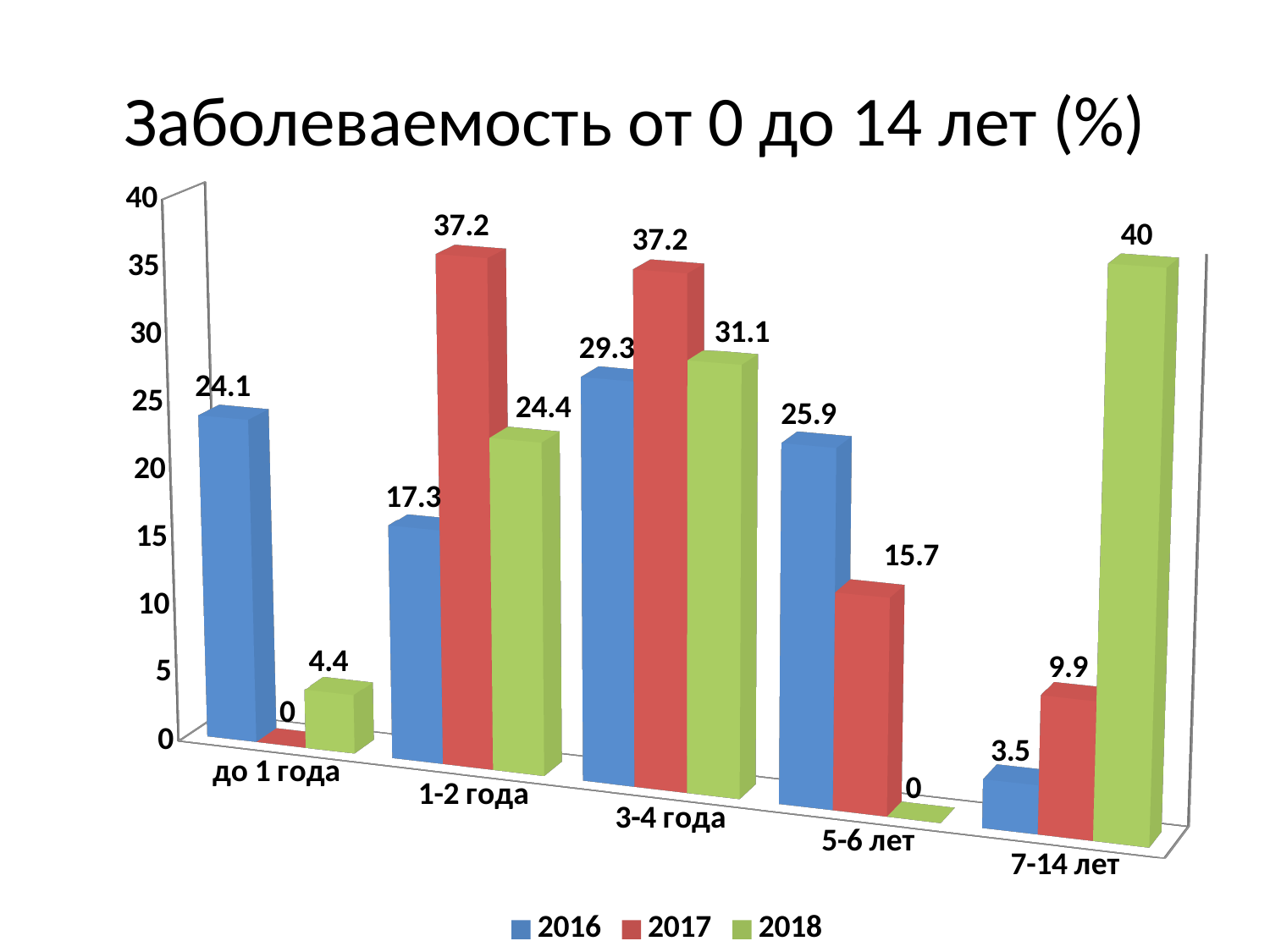
How many series does the legend list? 3 What is the value for 2017 in the '5-6 лет' category? 15.7 What is the difference between the 2017 and 2016 values in the '1-2 года' category? 19.9 Which is larger in the '3-4 года' category: the 2016 value or the 2018 value? 2018 Which colour represents the 2017 series in the legend? red Which category has the lowest value for the 2016 series? 7-14 лет How many age categories are shown on the x axis? 5 What kind of chart is shown on the slide? bar chart Which category has the highest value for the 2018 series? 7-14 лет What is the value for 2016 in the 'до 1 года' category? 24.1 What is the value for 2018 in the '7-14 лет' category? 40 What is the title of the chart? Заболеваемость от 0 до 14 лет (%)